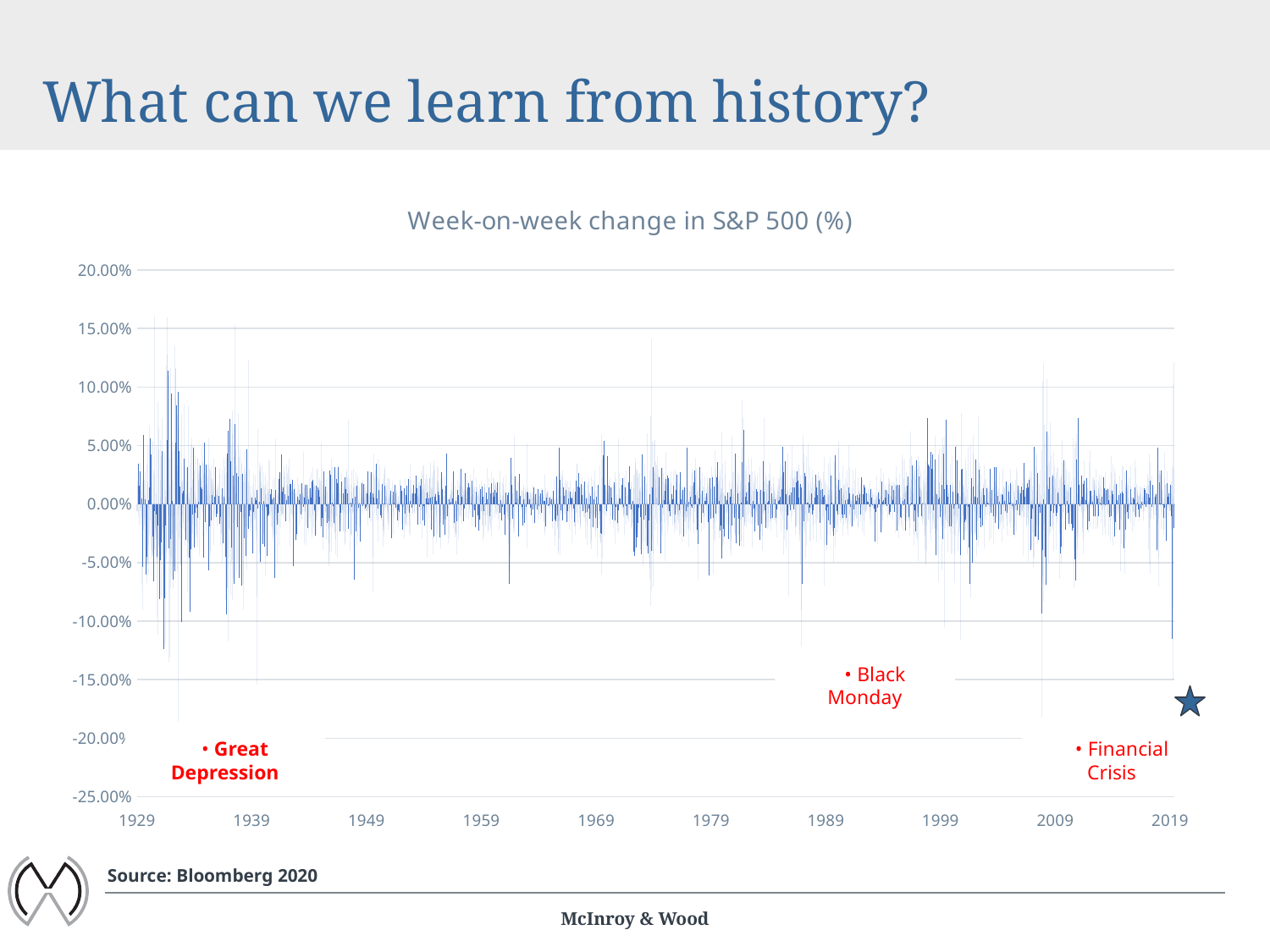
What is the lowest value labelled on the y axis of the chart? -25.00% What source is cited for the chart? Bloomberg 2020 What kind of chart is shown on the slide? Bar chart What is the title of the chart? Week-on-week change in S&P 500 (%) What is the last year labelled on the x axis of the chart? 2019 Which annotated event on the chart is placed near 1989? Black Monday How many year labels are shown on the x axis of the chart? 10 What is the first year labelled on the x axis of the chart? 1929 Is the largest positive weekly change shown in the chart (in the early 1930s) greater or less than 10.00%? greater What is the highest value labelled on the y axis of the chart? 20.00%